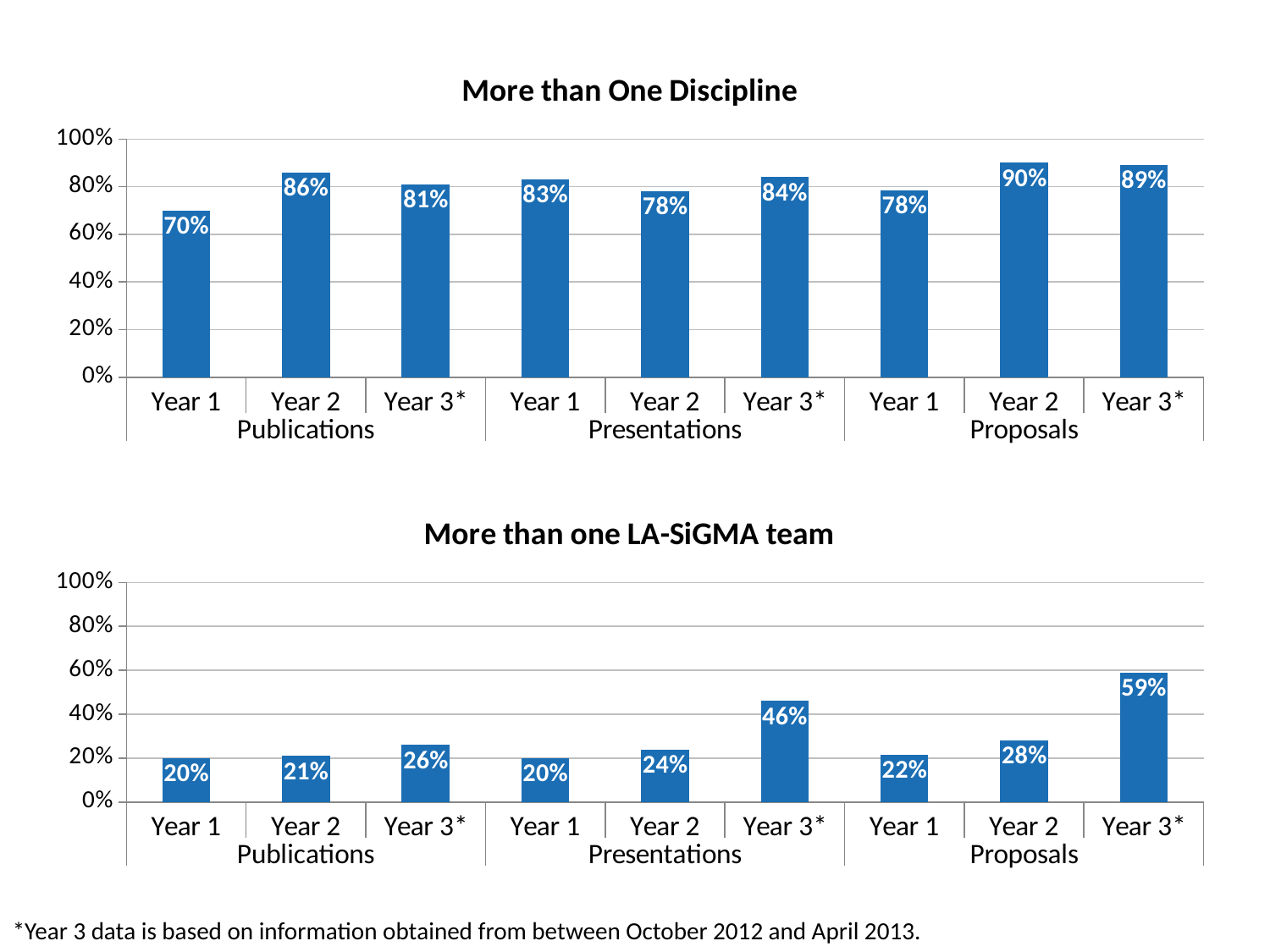
In the 'More than one LA-SiGMA team' chart, which bar is the highest? Proposals Year 3* In the 'More than one LA-SiGMA team' chart, what is the difference between Proposals Year 3* and Proposals Year 1? 37% In the 'More than One Discipline' chart, which is larger: Publications Year 2 or Presentations Year 1? Publications Year 2 In the 'More than one LA-SiGMA team' chart, do the values for Proposals rise or fall from Year 1 to Year 3*? rise What kind of chart is the 'More than One Discipline' chart? bar chart In the 'More than one LA-SiGMA team' chart, what is the value for Presentations Year 3*? 46% In the 'More than One Discipline' chart, which bar is the lowest? Publications Year 1 In the 'More than One Discipline' chart, what is the value for Proposals Year 2? 90% In the 'More than One Discipline' chart, what is the value for Publications Year 1? 70% In the 'More than One Discipline' chart, what is the difference between Presentations Year 3* and Presentations Year 2? 6% What is the title of the bottom chart on the slide? More than one LA-SiGMA team How many bars are in the 'More than one LA-SiGMA team' chart? 9